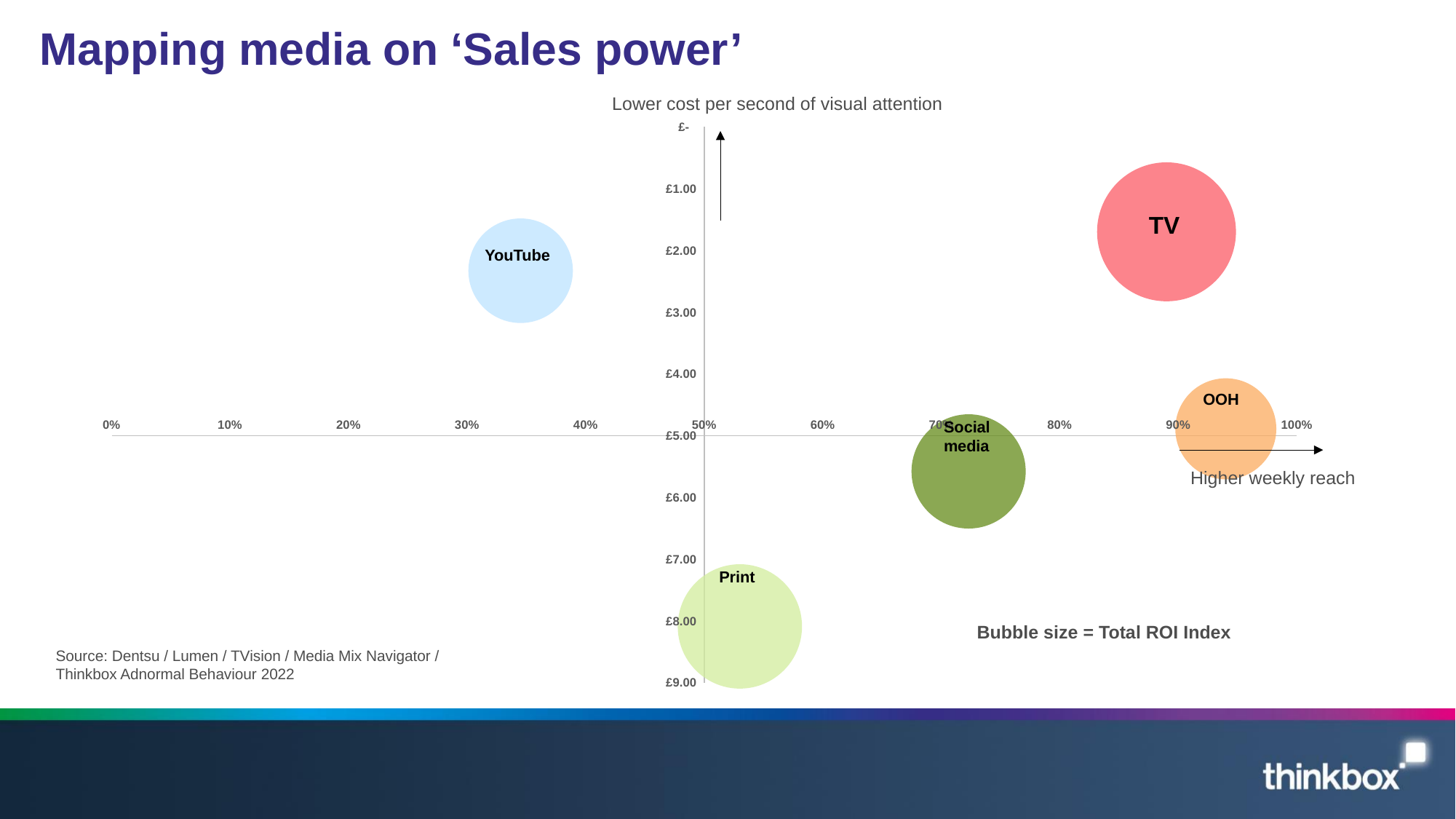
Which medium has the largest bubble, i.e. the highest Total ROI Index? TV How many media bubbles are plotted on the chart? 5 What does the bubble size represent according to the slide? Total ROI Index Is the cost per second of visual attention for Print greater or less than £7.00? greater Which has the higher weekly reach, TV or YouTube? TV What is the title of the slide? Mapping media on 'Sales power' What kind of chart is shown on the slide? Bubble chart Which medium has the lowest weekly reach (furthest left on the chart)? YouTube Which medium has the highest weekly reach (furthest right on the chart)? OOH Which medium has the highest cost per second of visual attention (lowest on the chart)? Print Is the weekly reach for TV greater or less than 80%? greater Is the weekly reach for YouTube greater or less than 40%? less